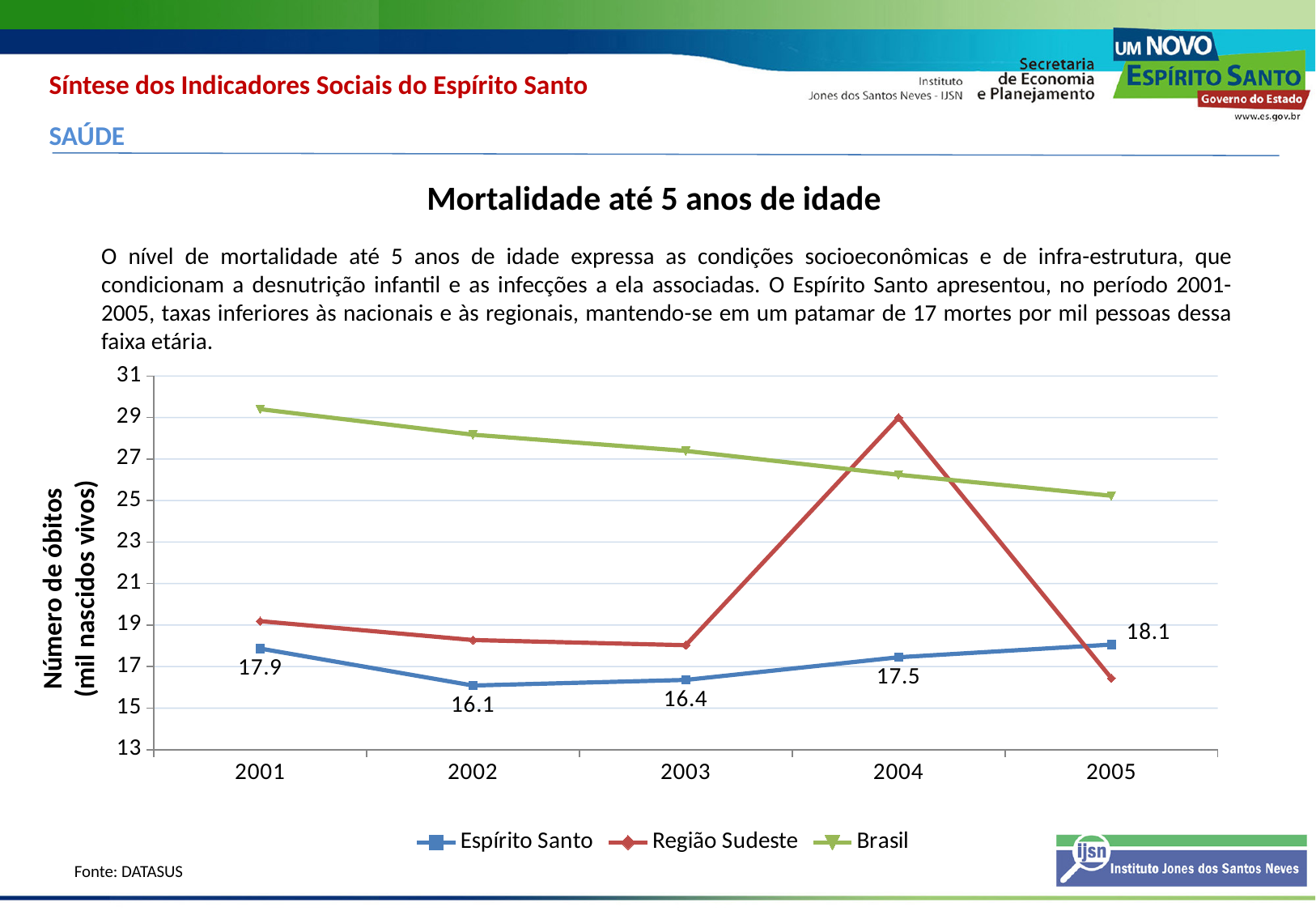
What is the value for Espírito Santo in 2001? 17.9 Which series has the higher value in 2003, Brasil or Espírito Santo? Brasil Is the value for Brasil in 2005 greater or less than 27? less How many years are shown on the x axis? 5 What is the value for Espírito Santo in 2002? 16.1 What kind of chart is shown? line chart In which year is the Espírito Santo value lowest? 2002 Is the value for Região Sudeste in 2004 greater or less than 27? greater In which year is the Espírito Santo value highest? 2005 How many series does the legend list? 3 Does the Brasil series rise or fall from 2001 to 2005? fall What is the difference between the Espírito Santo values for 2004 and 2003? 1.1